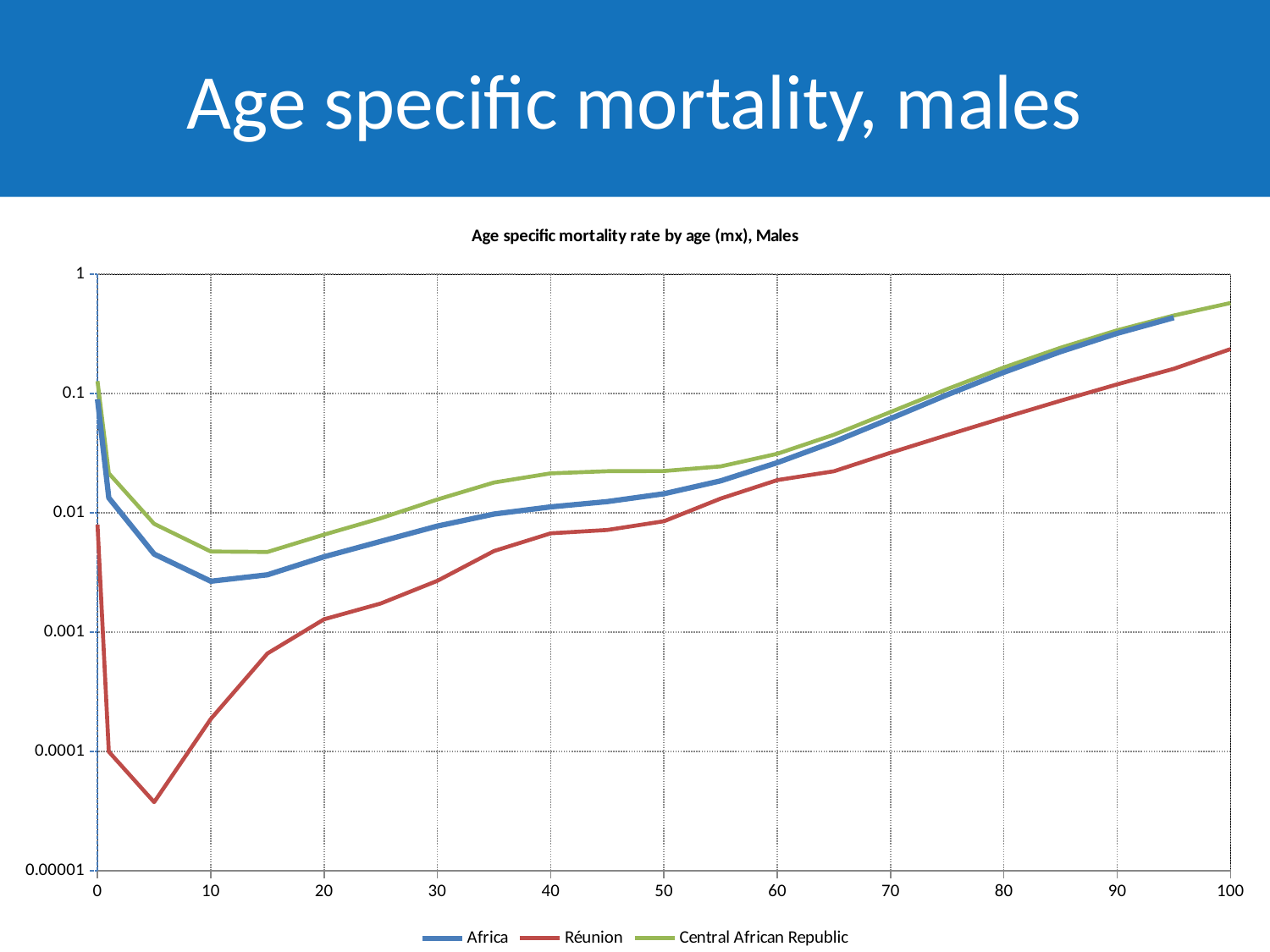
Which series has the highest value at age 30? Central African Republic Is the value for Central African Republic at age 100 greater or less than 0.1? greater Is the value for Africa at age 10 greater or less than 0.01? less Do the values for Réunion rise or fall between age 20 and age 100? rise Is the value for Réunion at age 100 greater or less than 0.1? greater How many series does the legend list? 3 What kind of chart is shown on the slide? line chart What is the title of the chart? Age specific mortality rate by age (mx), Males At age 50, which is larger: the value for Africa or the value for Réunion? Africa Which series has the lowest value at age 5? Réunion Which series is drawn in red? Réunion